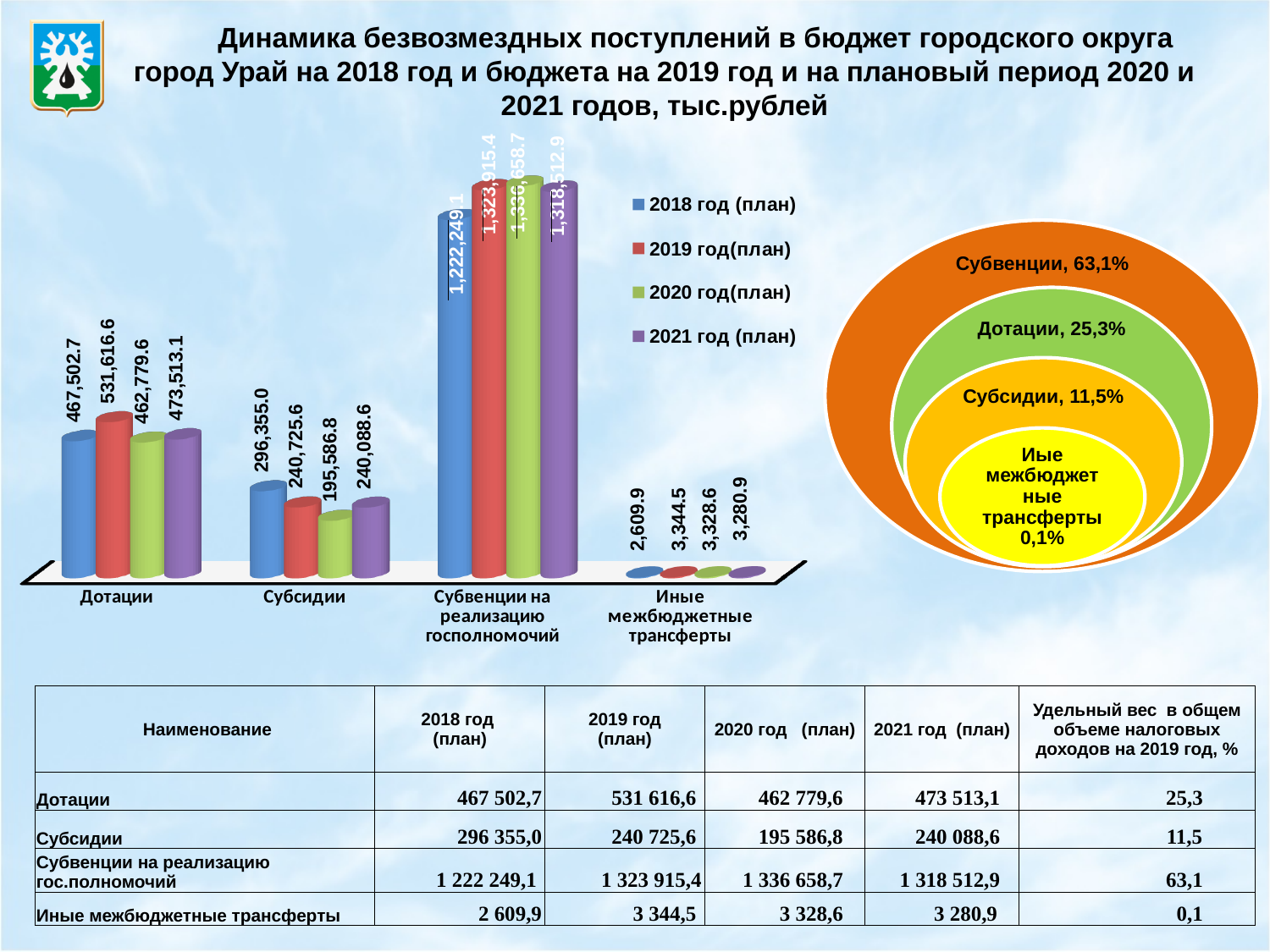
In the bar chart, what is the value for Дотации in the 2018 год (план) series? 467,502.7 How many categories are shown on the x axis of the bar chart? 4 In the bar chart, what is the value for Субсидии in the 2020 год(план) series? 195,586.8 In the bar chart, what is the difference between the 2018 год (план) and 2020 год(план) values for Субсидии? 100,768.2 In the bar chart, which year has the highest value for Дотации? 2019 год(план) In the bar chart, which category has the lowest values across all series? Иные межбюджетные трансферты In the bar chart, what is the difference between the 2019 год(план) and 2018 год (план) values for Дотации? 64,113.9 In the bar chart, what is the value for Иные межбюджетные трансферты in the 2019 год(план) series? 3,344.5 In the bar chart, which is larger for Субсидии: the 2019 год(план) value or the 2021 год (план) value? 2019 год(план) How many series does the bar chart's legend list? 4 In the bar chart, which category has the highest values across all series? Субвенции на реализацию госполномочий In the bar chart, what is the value for Субвенции на реализацию госполномочий in the 2020 год(план) series? 1,336,658.7